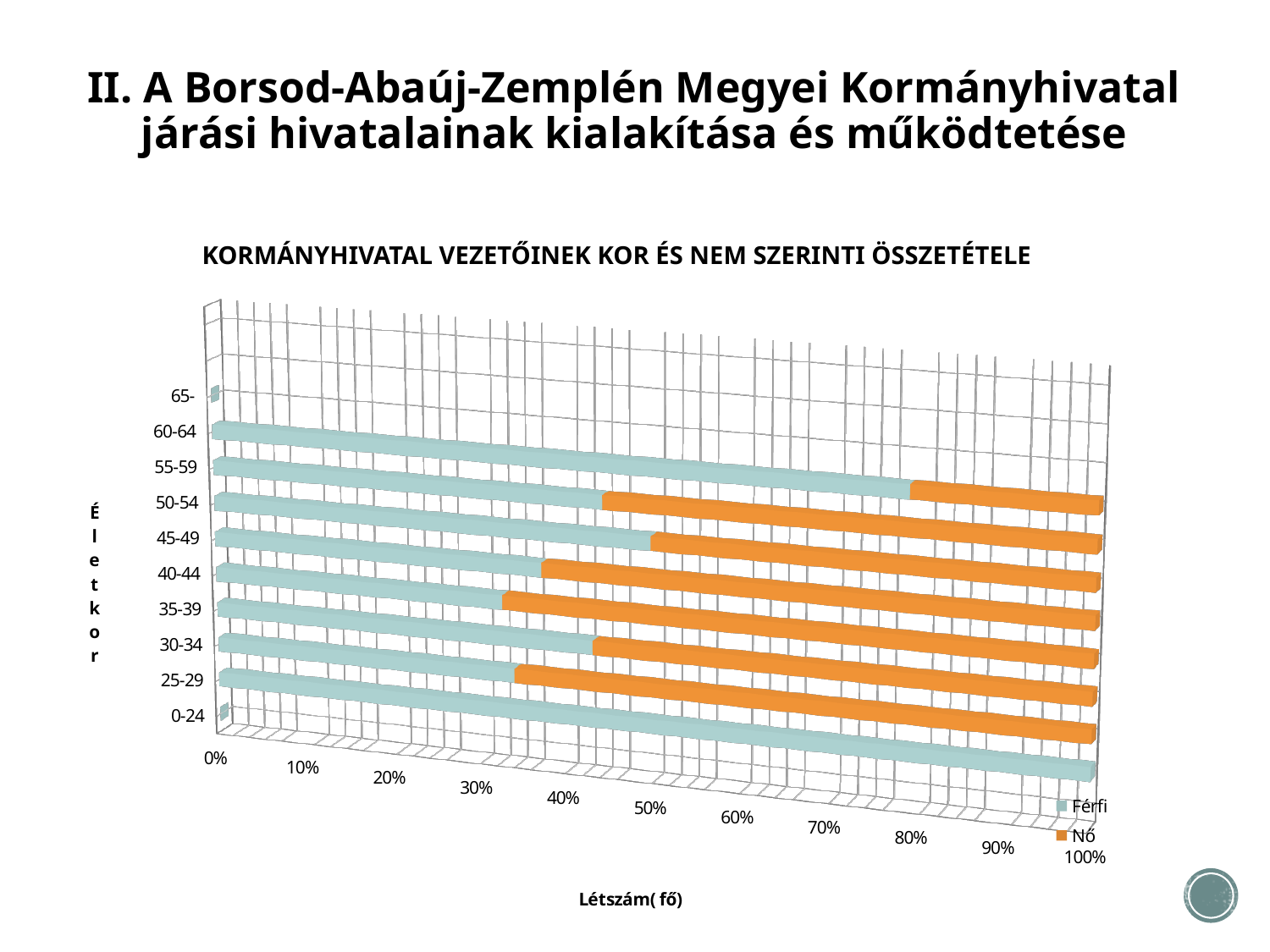
What are the two series named in the chart legend? Férfi and Nő What is the title of the chart? KORMÁNYHIVATAL VEZETŐINEK KOR ÉS NEM SZERINTI ÖSSZETÉTELE What kind of chart is shown on the slide? Stacked bar chart How many series does the chart legend list? 2 Which age group has the highest Férfi share in the chart? 25-29 For the 25-29 age group, which series has the larger share, Férfi or Nő? Férfi How many age groups are shown on the vertical axis of the chart? 10 Is the Férfi share for the 25-29 age group greater or less than 50%? greater Is the Férfi share for the 60-64 age group greater or less than 90%? less Is the Nő share for the 60-64 age group greater or less than 10%? greater For the 35-39 age group, which series has the larger share, Férfi or Nő? Nő